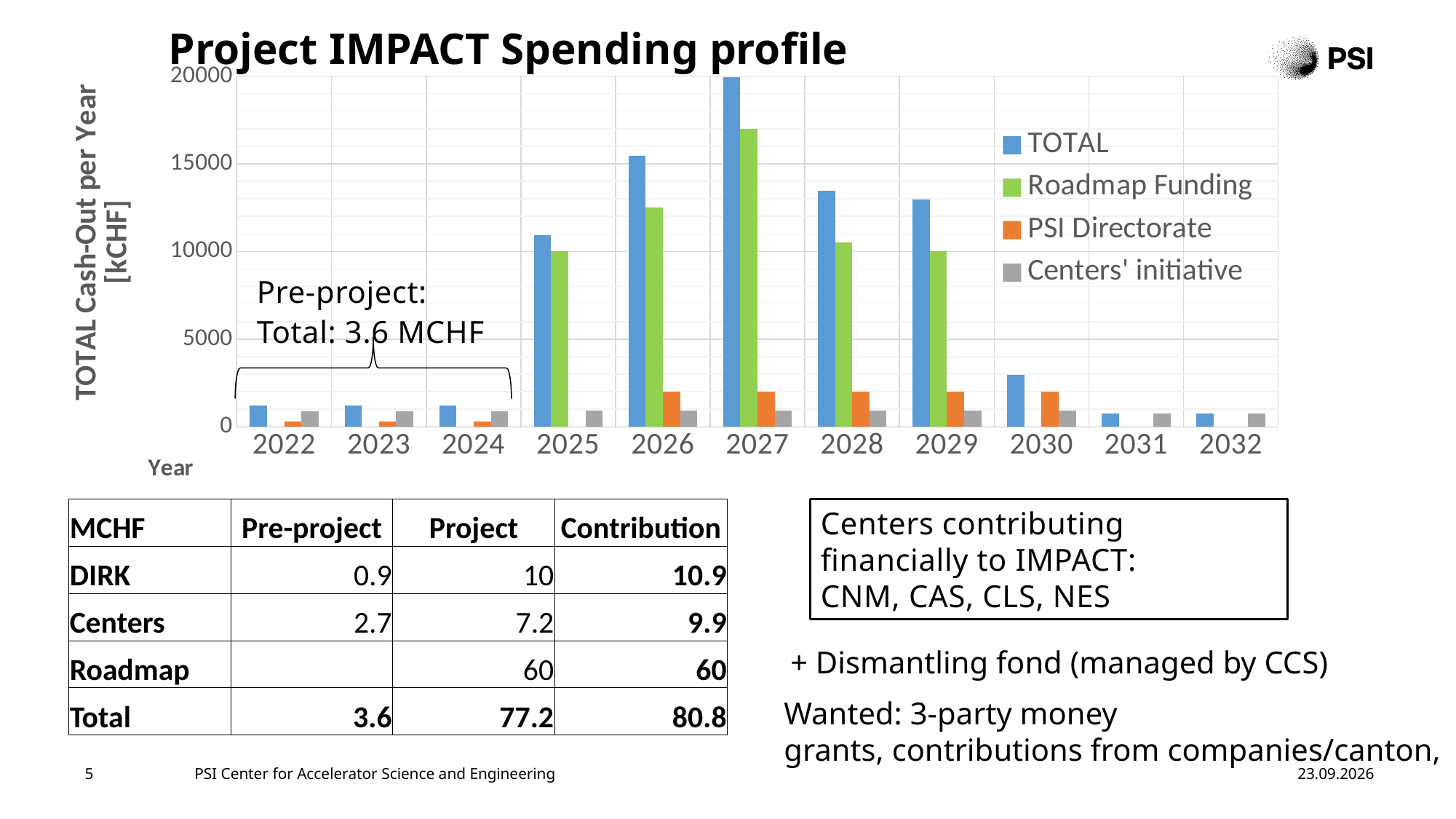
Which series is shown in green in the chart legend? Roadmap Funding Is the Roadmap Funding value for 2026 greater or less than 10000? greater How many years are shown on the x axis of the chart? 11 What is the title of the chart's vertical axis? TOTAL Cash-Out per Year [kCHF] Is the PSI Directorate value for 2027 greater or less than 5000? less What kind of chart is shown on the slide? bar chart Which year has the larger TOTAL value, 2026 or 2028? 2026 Is the TOTAL value for 2025 greater or less than 10000? greater Does the TOTAL value rise or fall from 2027 to 2030? fall How many series does the chart legend list? 4 In which year is the TOTAL bar highest? 2027